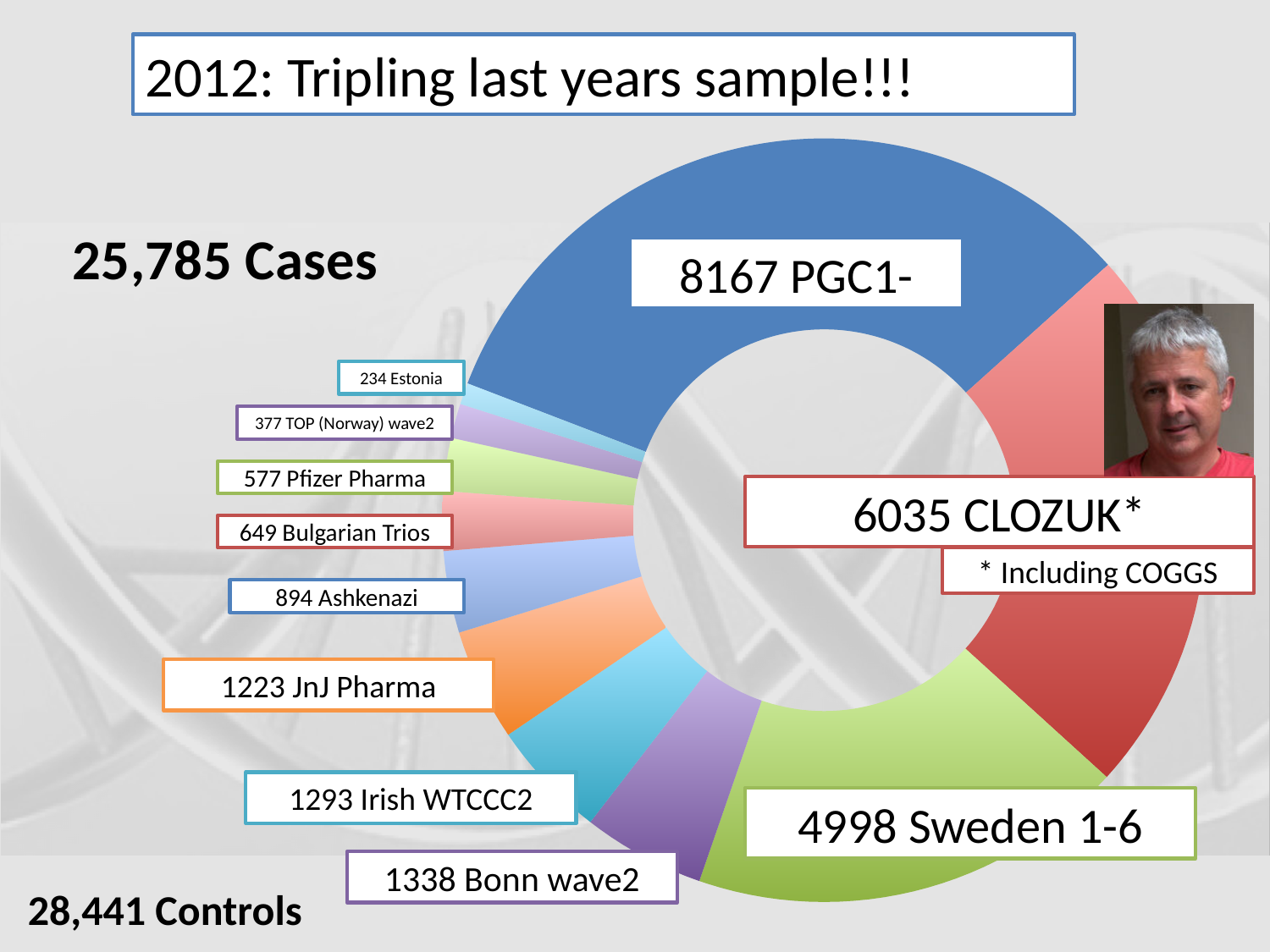
What is the total number of cases stated on the slide? 25,785 Cases What kind of chart is shown on the slide? Pie chart (doughnut) How many cases does the PGC1- segment represent? 8167 Which sample has the smallest segment in the chart? Estonia How many cases does the Irish WTCCC2 segment represent? 1293 What is the difference between the PGC1- and CLOZUK* case counts? 2132 How many cases does the Estonia segment represent? 234 Which has more cases, Bonn wave2 or JnJ Pharma? Bonn wave2 How many cases does the CLOZUK* segment represent? 6035 How many samples (segments) are shown in the chart? 11 Which sample has the largest segment in the chart? PGC1- How many cases does the Sweden 1-6 segment represent? 4998